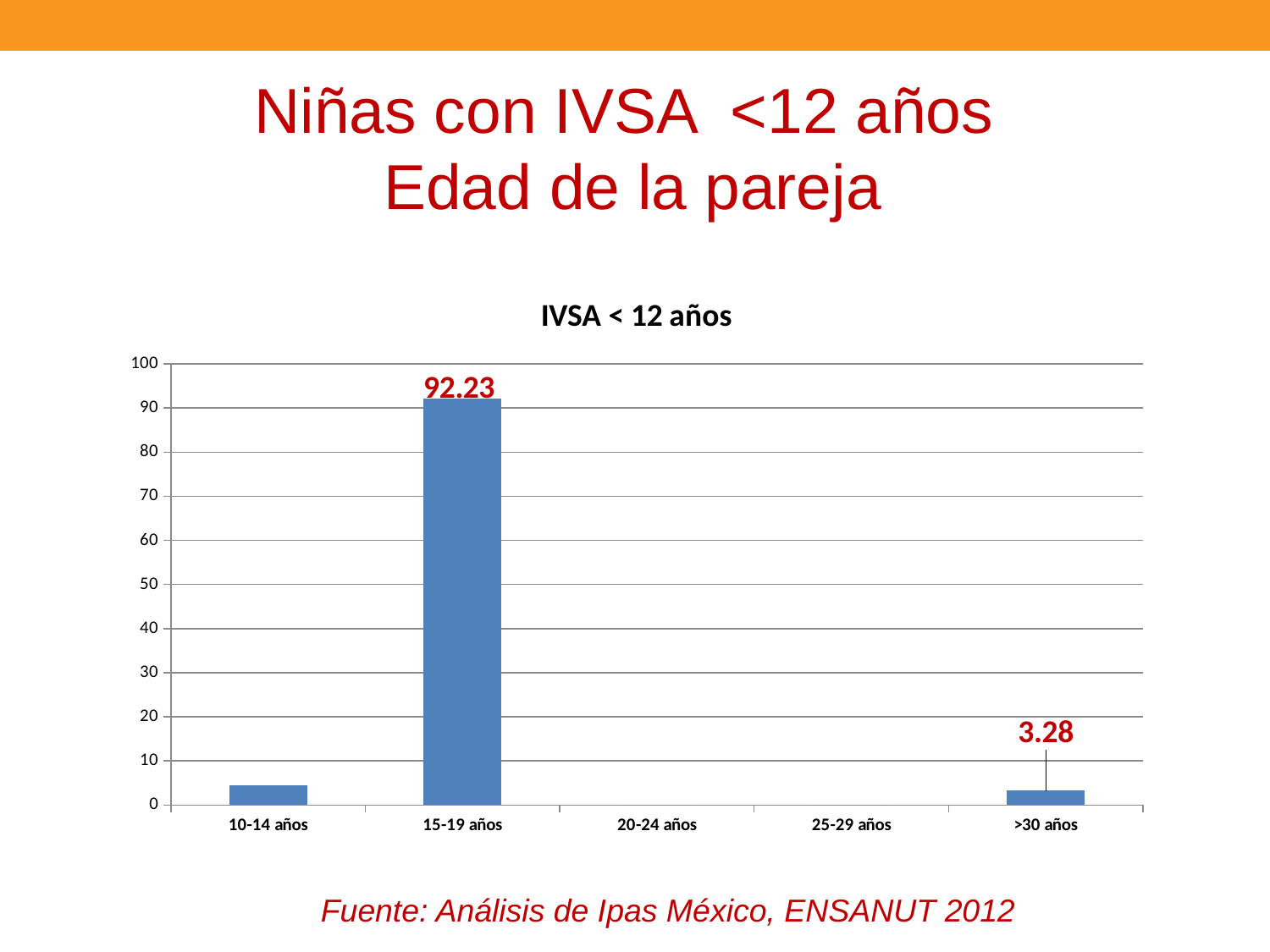
Is the value for 10-14 años greater or less than 10? less What is the difference between the value for 15-19 años and the value for >30 años? 88.95 What colour are the bars in the chart? blue What is the value for 15-19 años? 92.23 What is the maximum value shown on the y axis? 100 How many age categories are shown on the x axis? 5 What is the title of the chart? IVSA < 12 años Which is larger, the value for 15-19 años or the value for >30 años? 15-19 años What kind of chart is shown on the slide? bar chart Which age category has the highest value? 15-19 años Is the value for 15-19 años greater or less than 90? greater What is the value for >30 años? 3.28